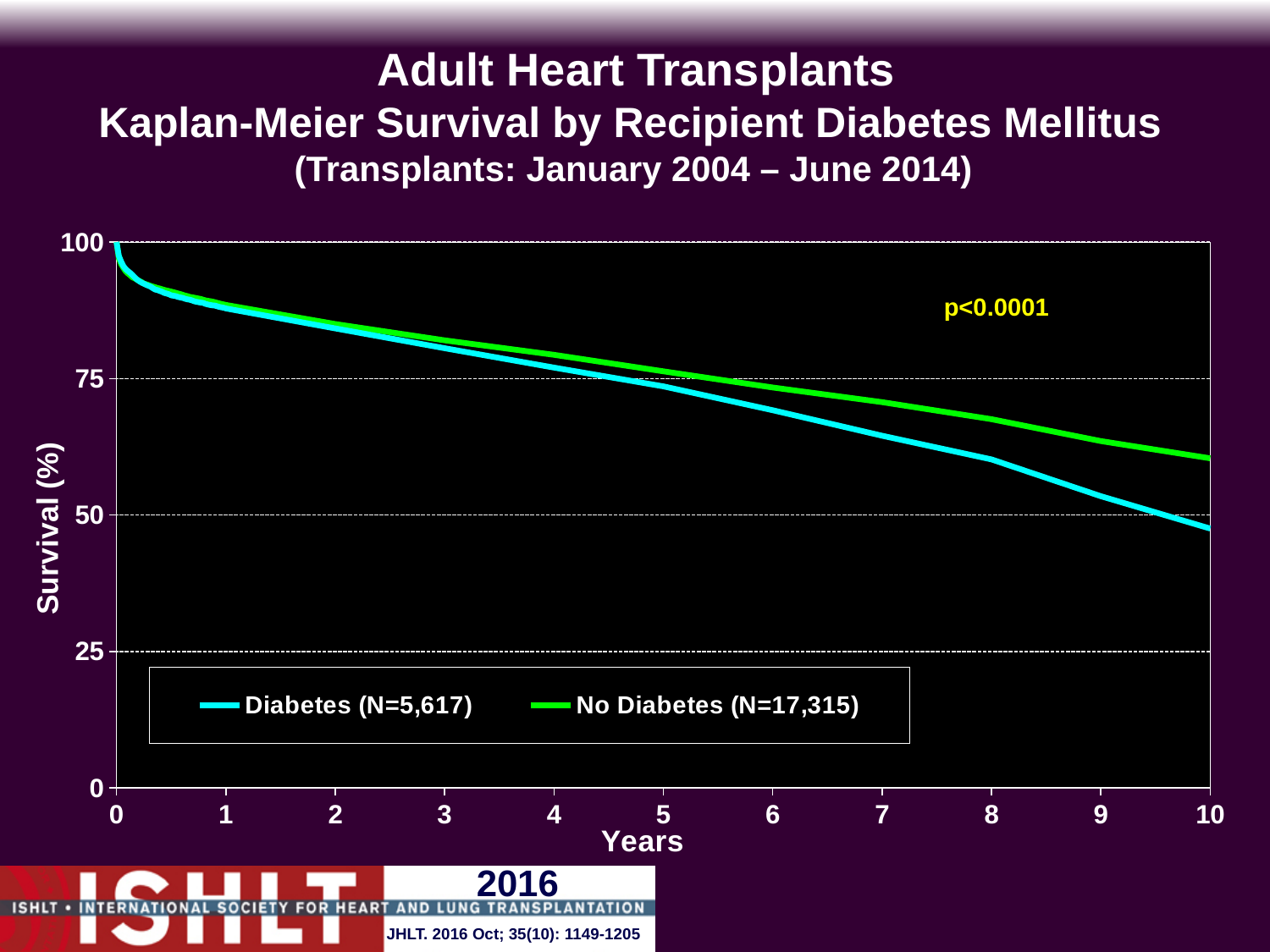
What kind of chart is shown on the slide? line chart Which series is shown in cyan (light blue)? Diabetes (N=5,617) What is the highest value shown on the x axis? 10 Do the survival curves rise or fall as years increase? fall Is the survival for the Diabetes group at 10 years greater or less than 50? less What p-value is printed on the chart? p<0.0001 Is the survival for the No Diabetes group at 10 years greater or less than 50? greater How many series does the legend list? 2 Is the survival for the No Diabetes group at 8 years greater or less than 75? less Which series has the higher survival at 10 years, Diabetes or No Diabetes? No Diabetes